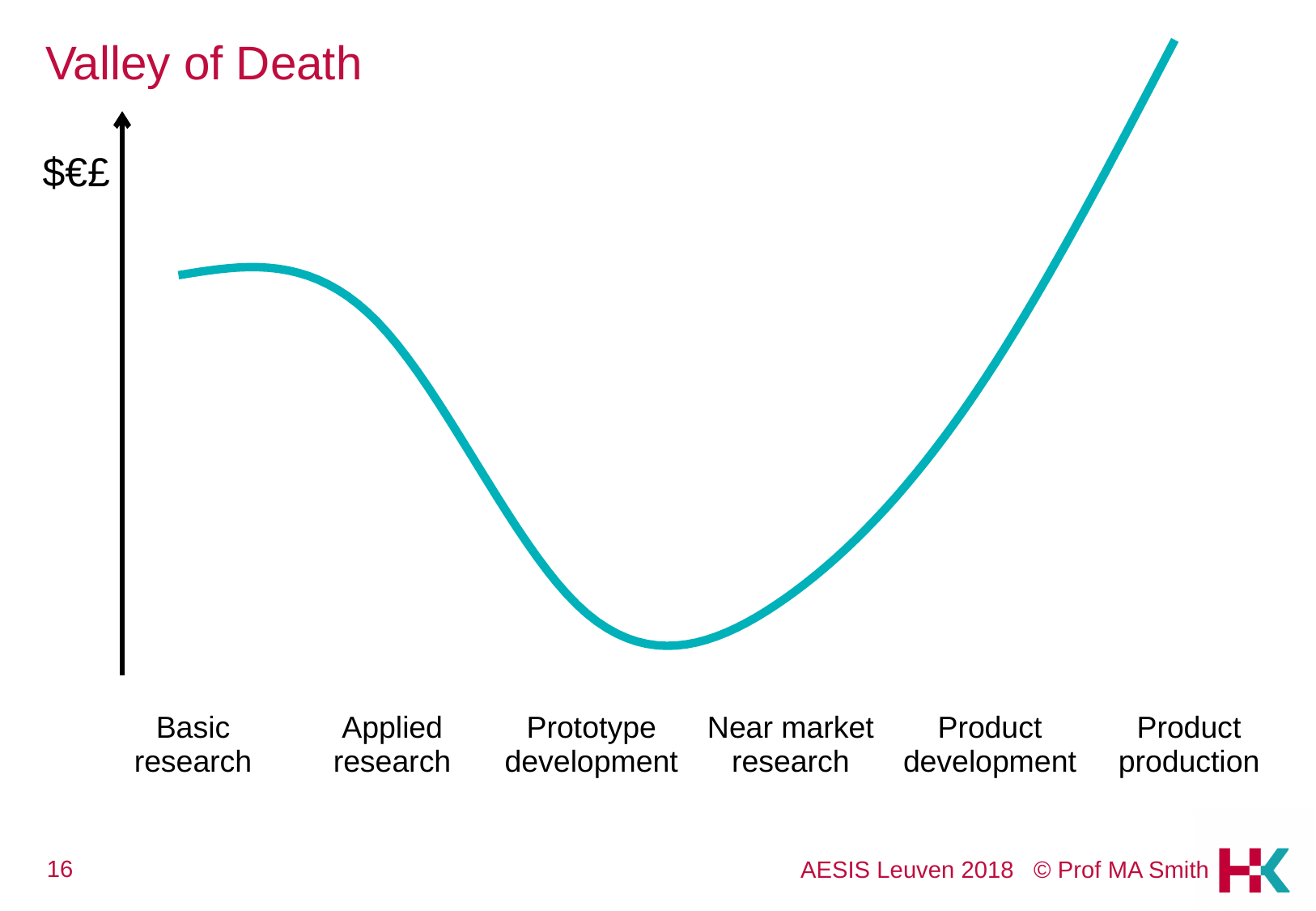
What kind of chart is shown on the slide? line chart What is the first stage labelled on the x axis? Basic research Does the curve rise or fall between Basic research and Prototype development? fall Which is higher on the curve, Product development or Near market research? Product development What is the last stage labelled on the x axis? Product production Which is higher on the curve, Basic research or Prototype development? Basic research What is the title of the chart? Valley of Death What label is shown on the vertical axis? $€£ Does the curve rise or fall between Near market research and Product production? rise Which is higher on the curve, Product production or Basic research? Product production At which stage does the curve reach its highest point? Product production How many stages are labelled along the x axis? 6